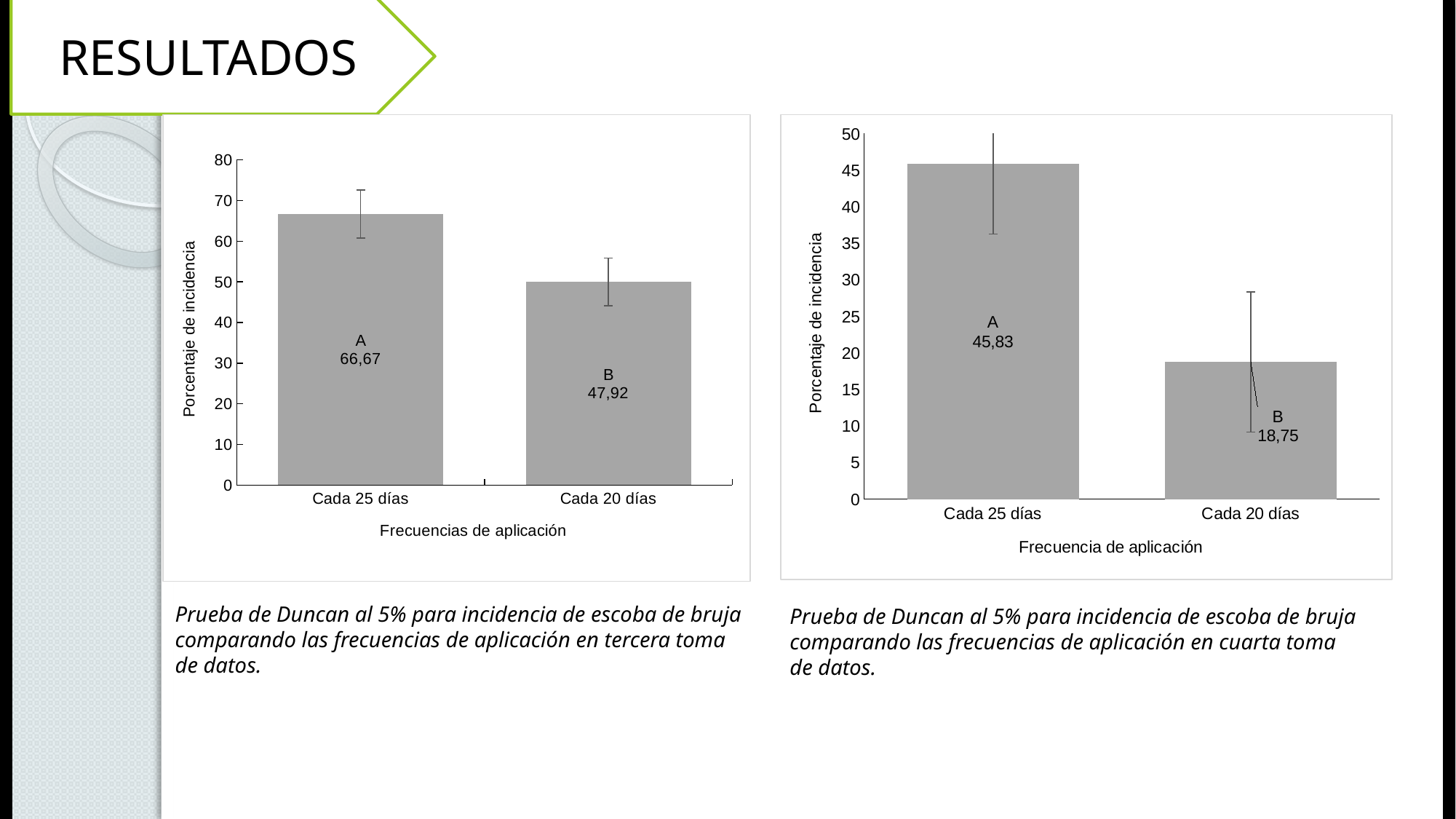
In the right chart, what is the value for Cada 20 días? 18,75 In the right chart, what is the difference between the values for Cada 25 días and Cada 20 días? 27,08 In the right chart, is the value for Cada 25 días greater or less than 40? greater What is the y-axis label of the left chart? Porcentaje de incidencia In the left chart, what is the value for Cada 20 días? 47,92 How many categories are shown on the x axis of the left chart? 2 In the right chart, which application frequency has the lowest incidence? Cada 20 días In the left chart, what is the value for Cada 25 días? 66,67 In the left chart, which application frequency has the highest incidence? Cada 25 días What kind of chart is the right chart? bar chart In the right chart, what is the value for Cada 25 días? 45,83 In the left chart, what is the difference between the values for Cada 25 días and Cada 20 días? 18,75